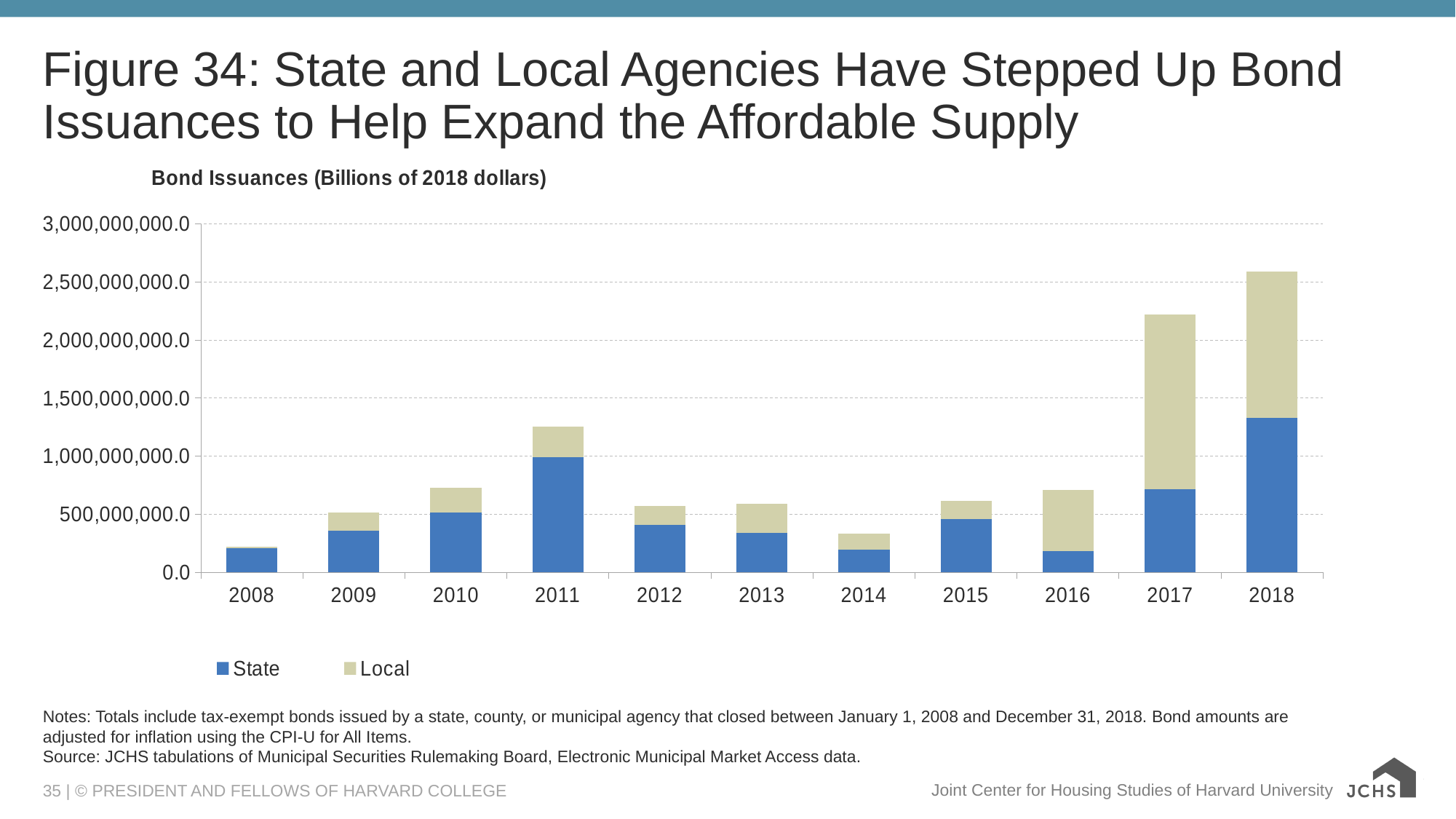
Is the total bond issuance for 2018 greater or less than 2,500,000,000.0? greater Do total bond issuances rise or fall from 2016 to 2018? rise How many years are shown on the x axis of the chart? 11 Which year has the highest total bond issuances? 2018 Which year has the lowest total bond issuances? 2008 How many series does the legend list? 2 What kind of chart is shown on the slide? Stacked bar chart Is the total bond issuance for 2014 greater or less than 500,000,000.0? less Is the total bond issuance for 2017 greater or less than 2,000,000,000.0? greater What is the axis title shown above the chart? Bond Issuances (Billions of 2018 dollars) Which year has a larger total bond issuance, 2011 or 2010? 2011